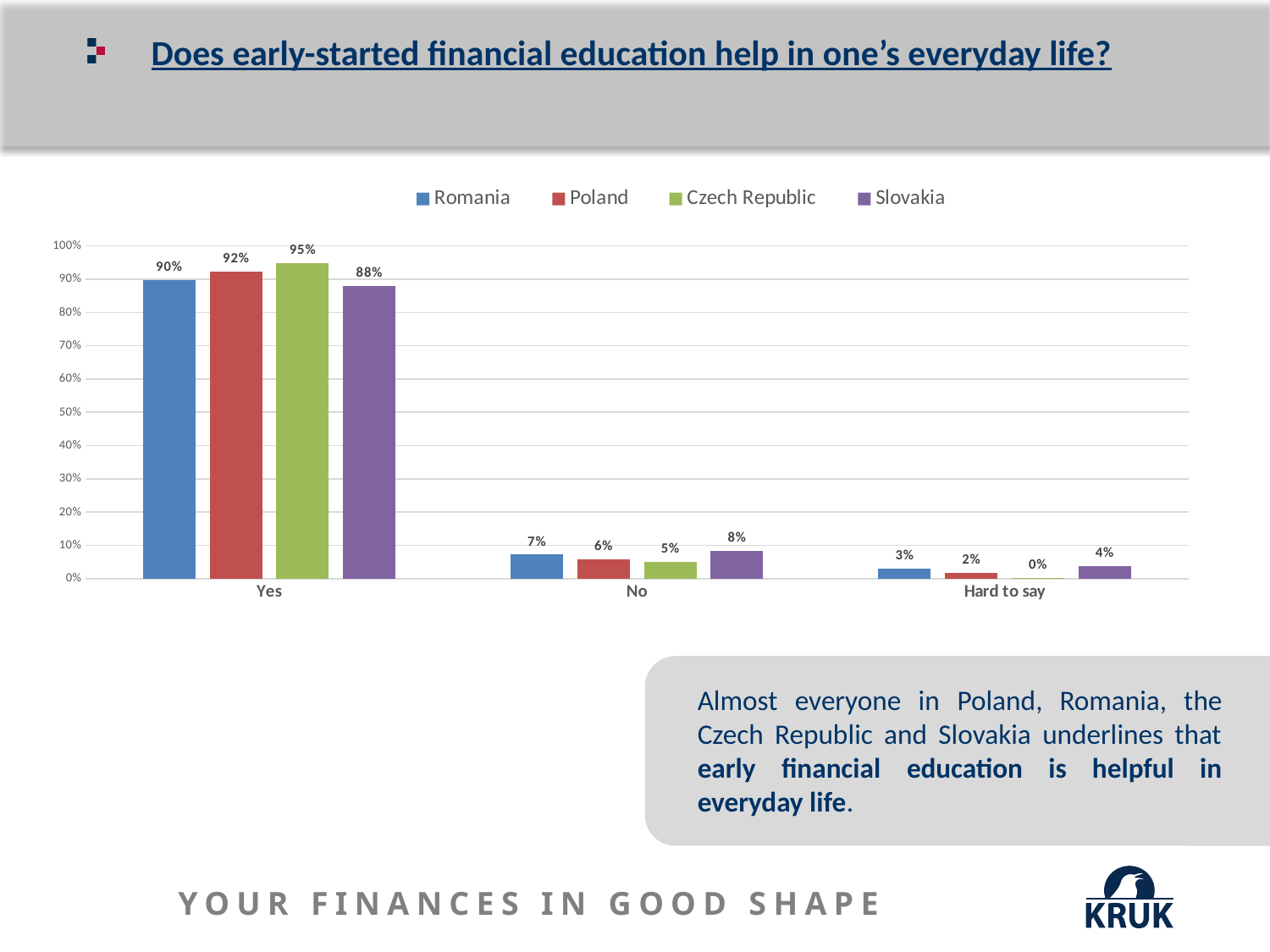
Which country has the highest value in the "Yes" category? Czech Republic What is the value for Slovakia in the "No" category? 8% Is the value for Slovakia in the "Yes" category greater or less than 80%? greater Which colour represents Slovakia in the chart? Purple What is the value for Poland in the "Hard to say" category? 2% What is the difference between Poland's and Slovakia's values in the "Yes" category? 4% How many series does the legend list? 4 Which country has the lowest value in the "Hard to say" category? Czech Republic What kind of chart is shown on the slide? Bar chart What percentage of respondents in the Czech Republic answered "Yes"? 95% Which is larger in the "No" category: the value for Romania or the value for Poland? Romania How many answer categories are shown on the x axis? 3